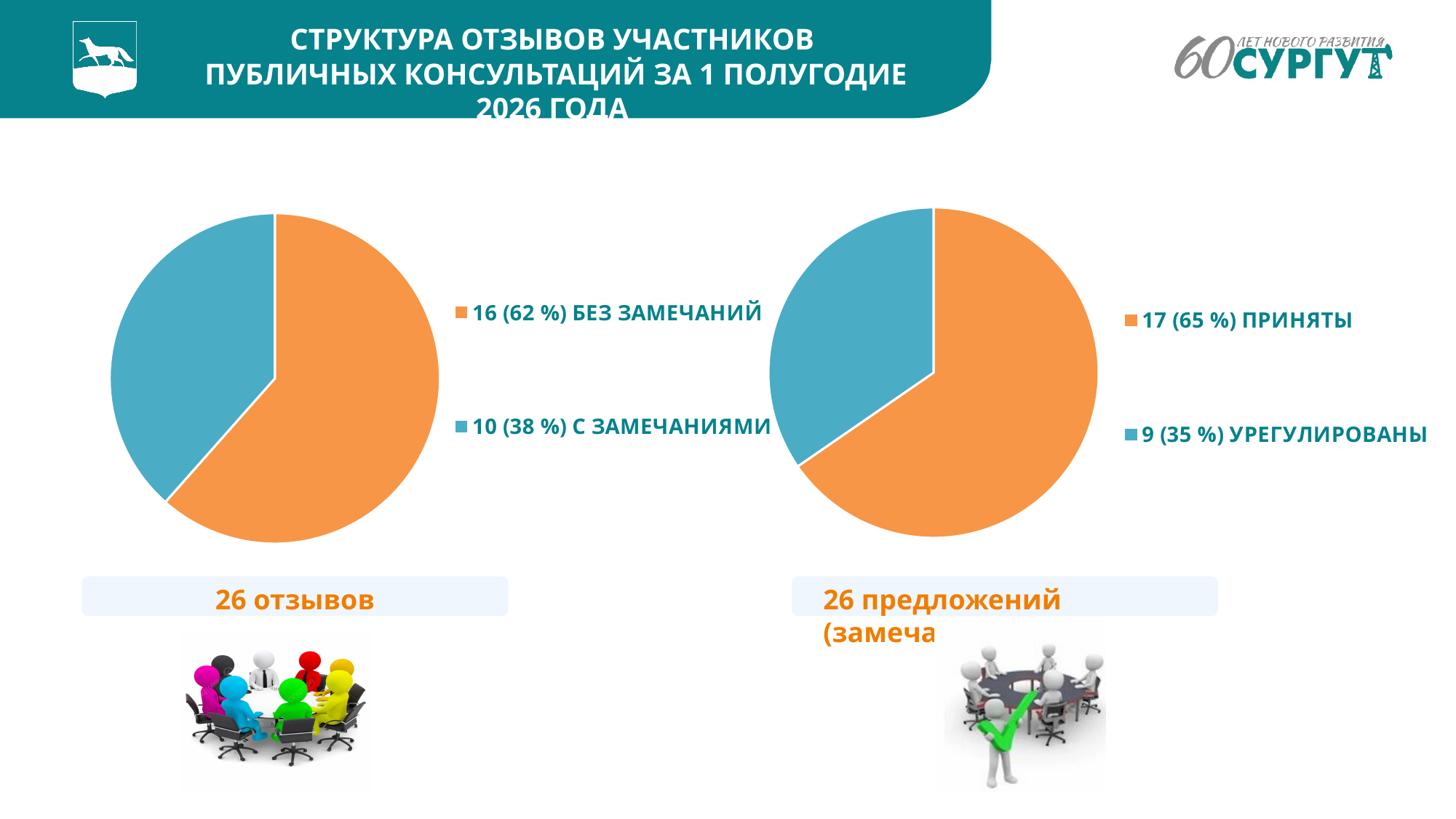
In the left pie chart, what share of reviews is С ЗАМЕЧАНИЯМИ? 38 % In the left pie chart, which category is the largest? БЕЗ ЗАМЕЧАНИЙ In the right pie chart, what is the total of ПРИНЯТЫ and УРЕГУЛИРОВАНЫ? 26 Which is larger: the number of reviews С ЗАМЕЧАНИЯМИ in the left chart or the number of proposals УРЕГУЛИРОВАНЫ in the right chart? С ЗАМЕЧАНИЯМИ What type of chart is the left chart on the slide? pie chart In the right pie chart, how many proposals are labelled ПРИНЯТЫ? 17 In the right pie chart, which category is the smallest? УРЕГУЛИРОВАНЫ How many slices does the left pie chart have? 2 In the right pie chart, what share of proposals is УРЕГУЛИРОВАНЫ? 35 % In the left pie chart, how many reviews are labelled БЕЗ ЗАМЕЧАНИЙ? 16 In the left pie chart, what is the difference between the number of reviews БЕЗ ЗАМЕЧАНИЙ and С ЗАМЕЧАНИЯМИ? 6 In the right pie chart, what colour is the ПРИНЯТЫ slice? orange